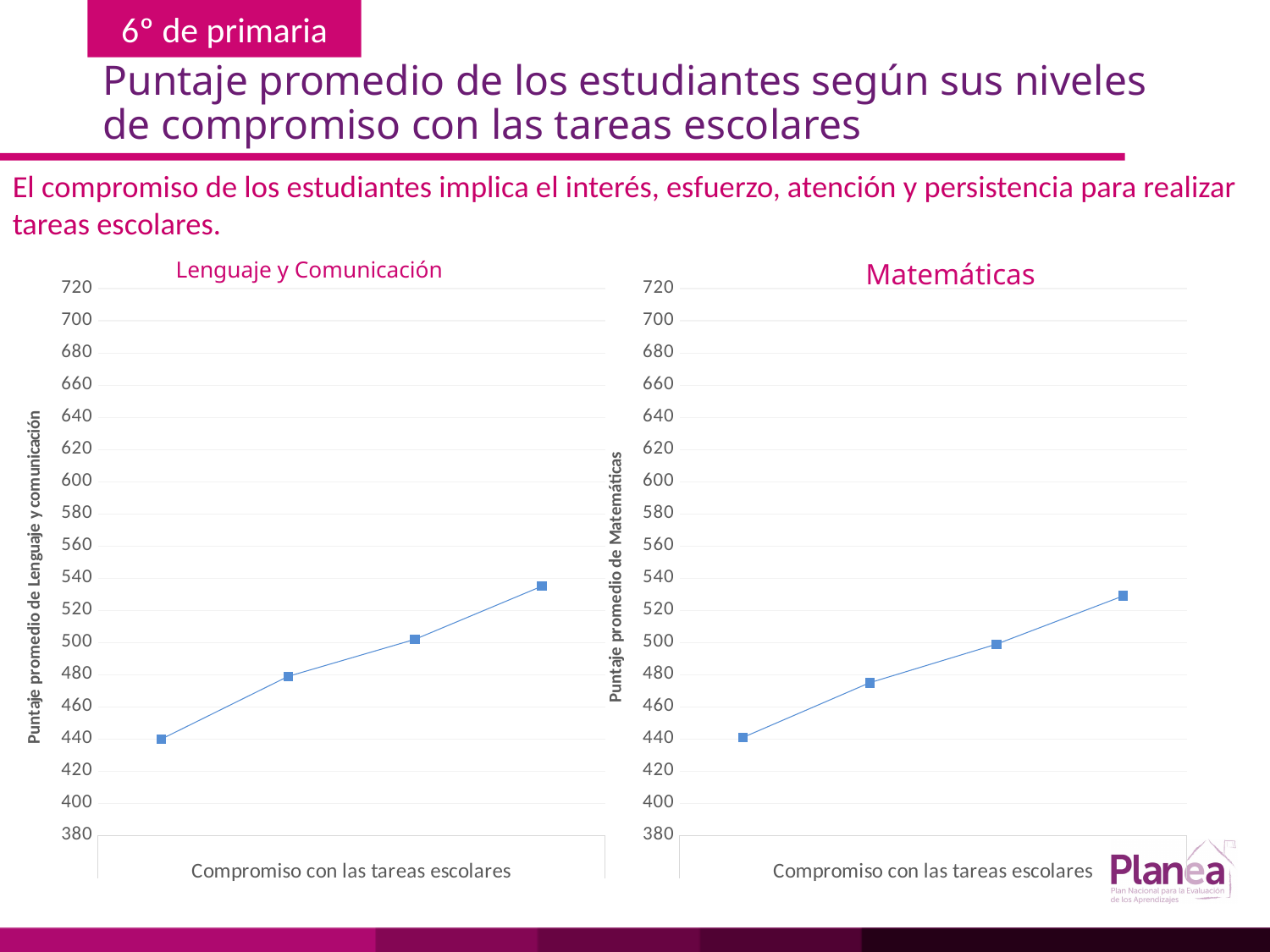
In the Lenguaje y Comunicación chart, do the values rise or fall from left to right along the x axis? rise In the Lenguaje y Comunicación chart, is the value of the rightmost point greater or less than 520? greater In the Matemáticas chart, is the value of the leftmost point greater or less than 460? less In the Matemáticas chart, is the value of the rightmost point greater or less than 500? greater How many data points are plotted in the Lenguaje y Comunicación chart? 4 What kind of chart is the Matemáticas chart? line chart How many data points are plotted in the Matemáticas chart? 4 In the Matemáticas chart, which point has the highest value, the leftmost or the rightmost? the rightmost In the Matemáticas chart, do the values rise or fall from left to right along the x axis? rise What is the x-axis label of the Lenguaje y Comunicación chart? Compromiso con las tareas escolares What kind of chart is the Lenguaje y Comunicación chart? line chart